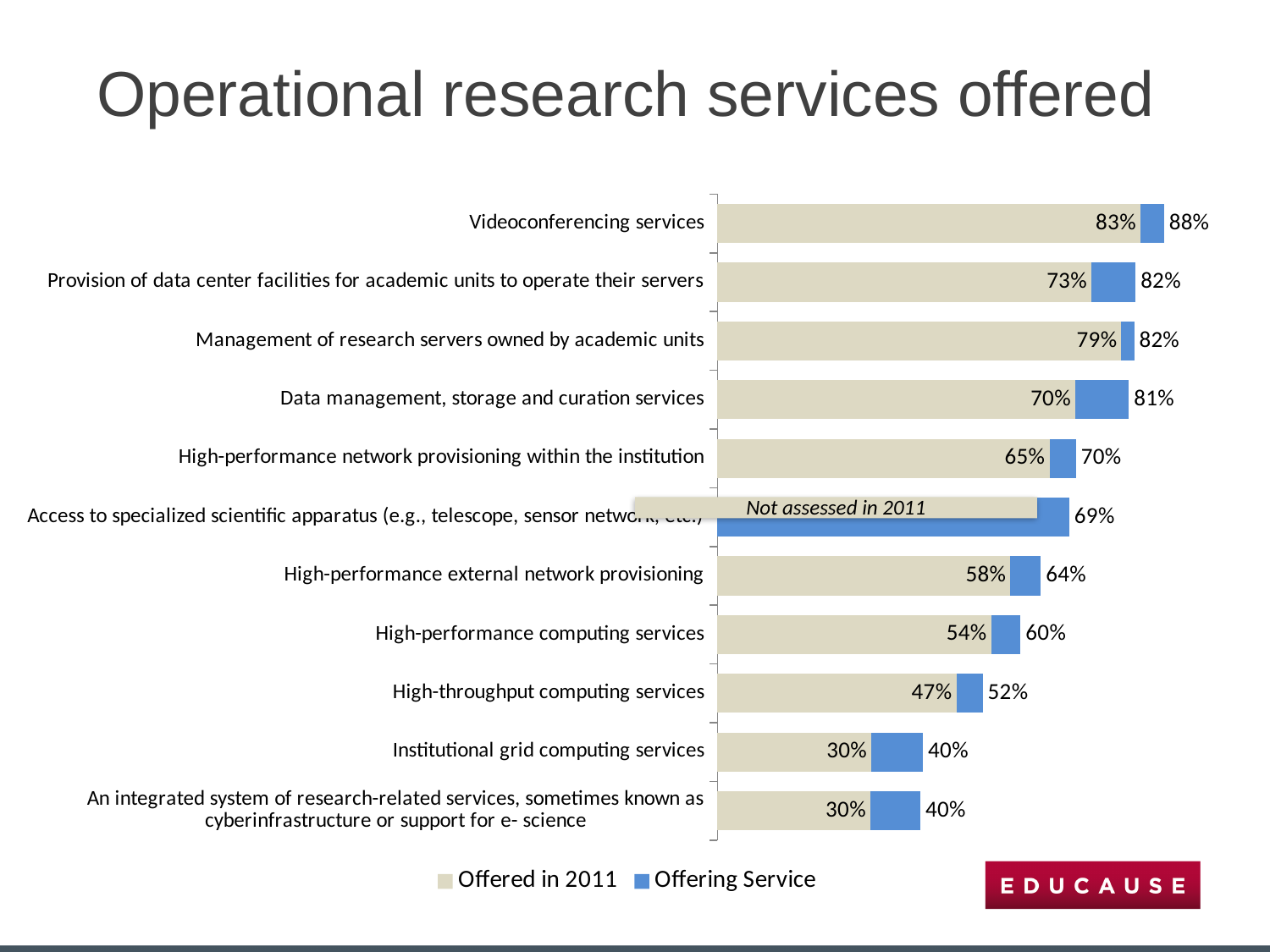
Which category has the lowest Offered in 2011 value? Institutional grid computing services and An integrated system of research-related services (both 30%) What kind of chart is shown on the slide? Bar chart What percentage was Data management, storage and curation services Offered in 2011? 70% What percentage is shown for Videoconferencing services in the Offering Service series? 88% Which category has the highest Offering Service value? Videoconferencing services How many categories are shown on the chart? 11 What are the two series named in the legend? Offered in 2011 and Offering Service What is the difference between the Offering Service and Offered in 2011 values for Institutional grid computing services? 10 percentage points What note is shown for the Offered in 2011 value of Access to specialized scientific apparatus? Not assessed in 2011 How many series does the legend list? 2 What is the Offering Service value for High-throughput computing services? 52% Which is larger: the Offered in 2011 value for Management of research servers owned by academic units or for Provision of data center facilities for academic units to operate their servers? Management of research servers owned by academic units